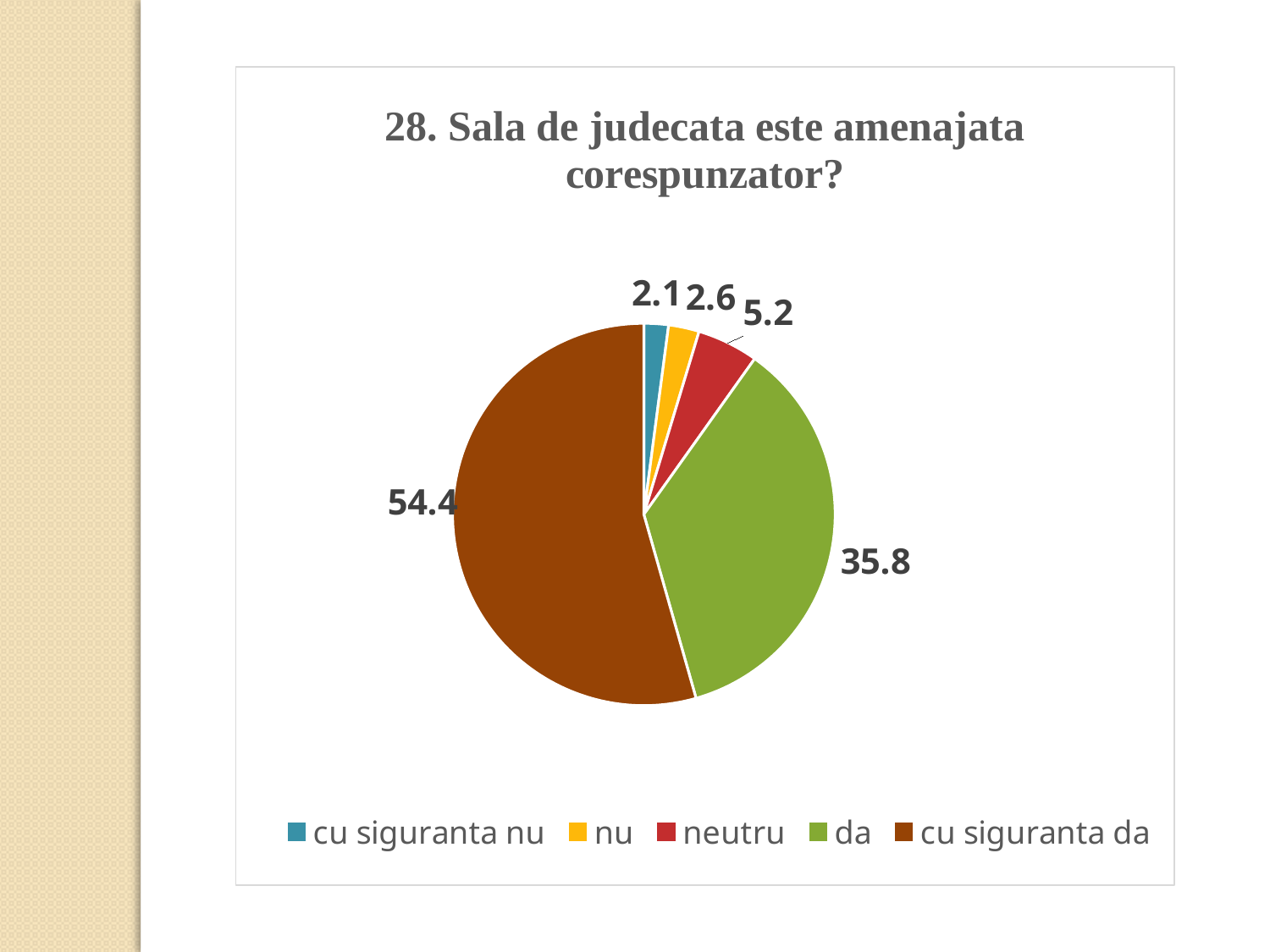
What kind of chart is shown on the slide? pie chart Which is larger, the value for "neutru" or the value for "nu"? neutru What is the value for "cu siguranta da"? 54.4 What is the difference between the values for "cu siguranta da" and "da"? 18.6 Which category has the smallest slice? cu siguranta nu What is the value for "cu siguranta nu"? 2.1 What is the value for "da"? 35.8 What is the title of the chart? 28. Sala de judecata este amenajata corespunzator? What is the value for "neutru"? 5.2 Which category has the largest slice? cu siguranta da How many categories does the legend list? 5 What is the value for "nu"? 2.6